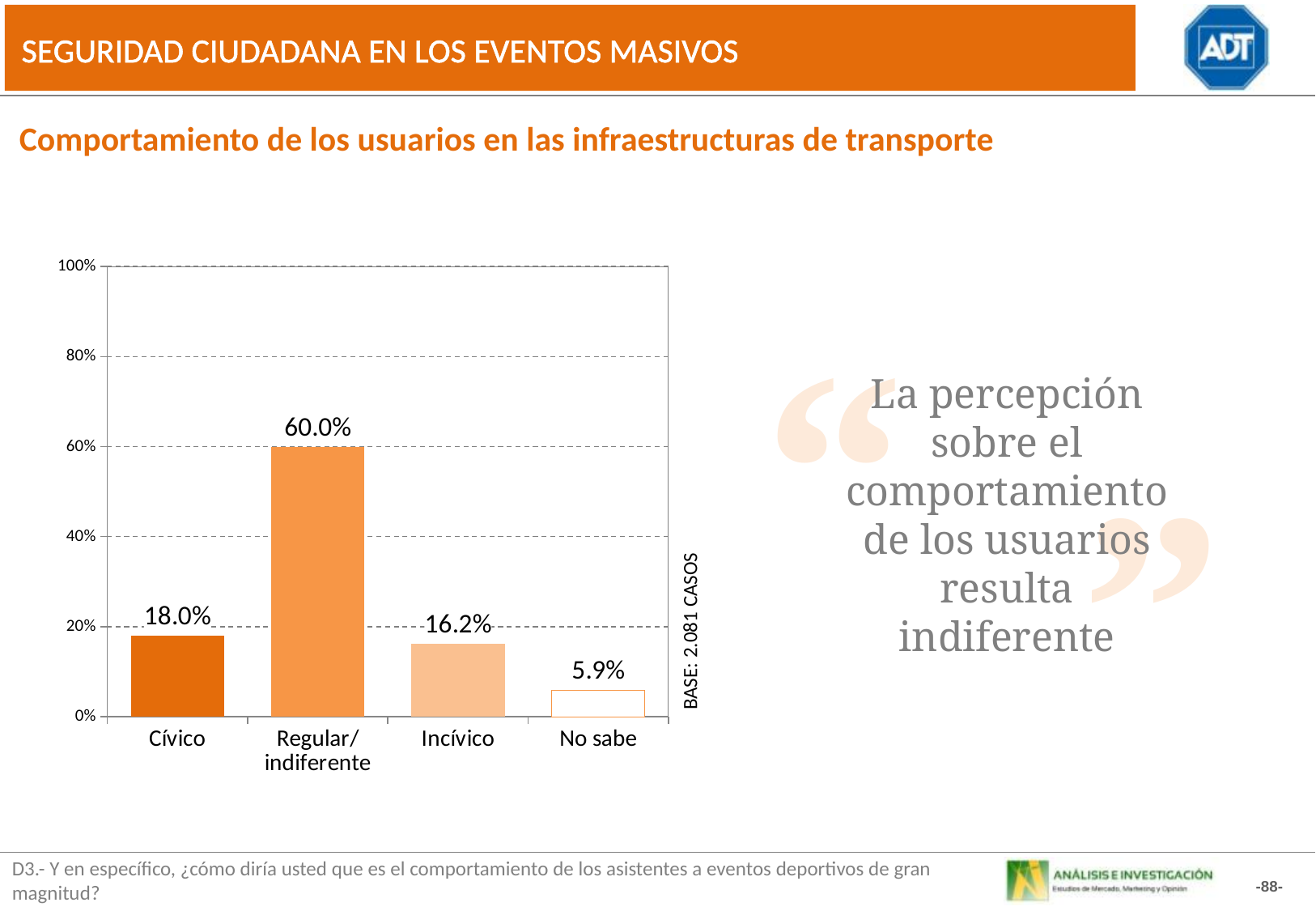
Which category has the lowest value? No sabe What is the difference between the values for Cívico and Incívico? 1.8% Which category has the highest value? Regular/indiferente Is the value for Regular/indiferente greater or less than 40%? greater How many categories are shown on the x axis of the chart? 4 What is the value for Incívico? 16.2% What is the value for No sabe? 5.9% What is the value for Cívico? 18.0% Which is larger, the value for Cívico or the value for No sabe? Cívico What is the difference between the values for Regular/indiferente and Cívico? 42.0% What is the value for Regular/indiferente? 60.0% What kind of chart is shown on the slide? Bar chart